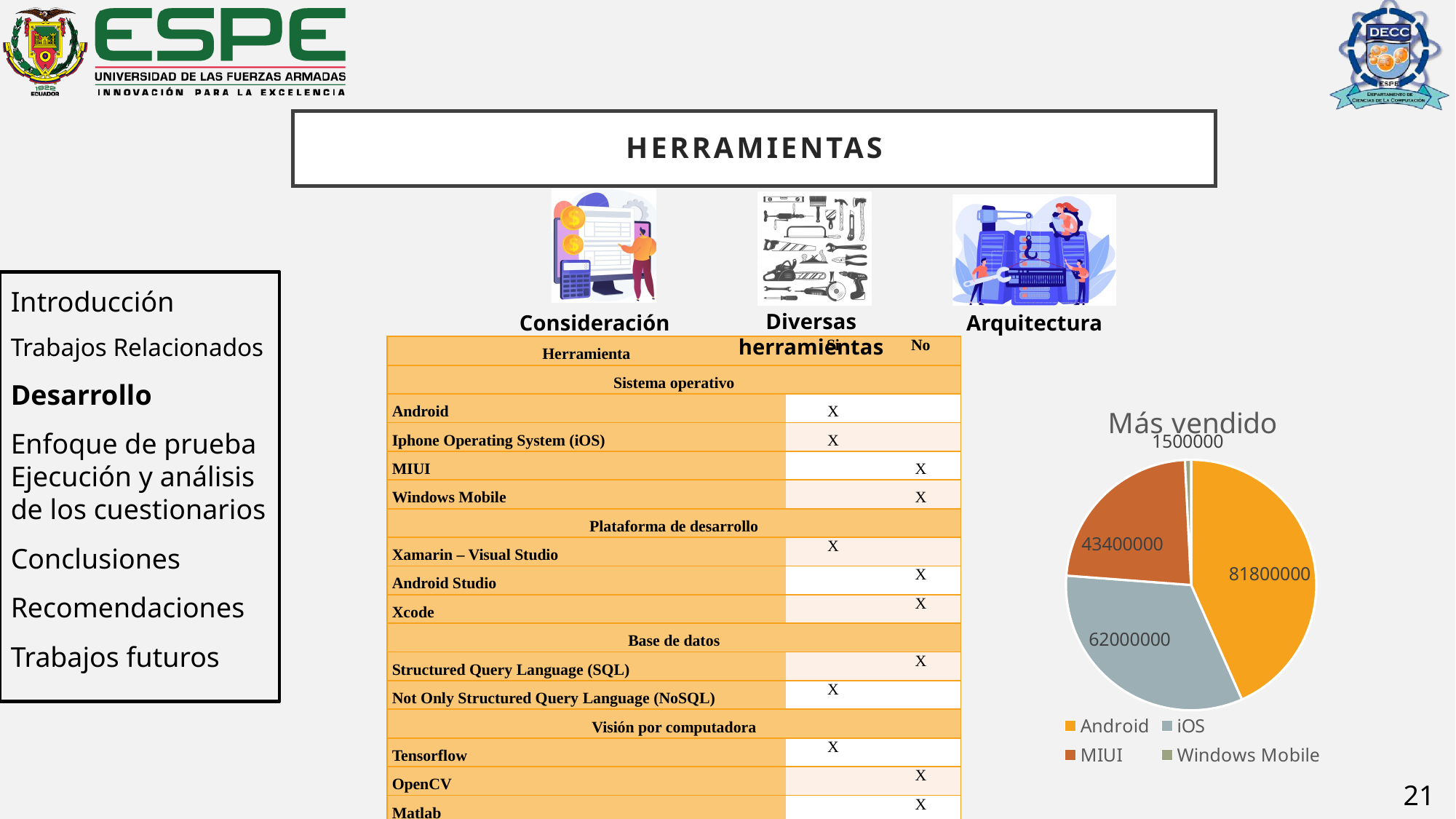
Which category has the smallest slice in the "Más vendido" pie chart? Windows Mobile In the "Más vendido" pie chart, what is the difference between the Android and iOS values? 19800000 What type of chart is shown under the title "Más vendido"? pie chart What is the title of the pie chart on the slide? Más vendido How many categories does the legend of the "Más vendido" pie chart list? 4 In the "Más vendido" pie chart, what is the value for MIUI? 43400000 In the "Más vendido" pie chart, which is larger, the value for iOS or the value for MIUI? iOS In the "Más vendido" pie chart, what is the difference between the iOS and MIUI values? 18600000 In the "Más vendido" pie chart, what is the value for iOS? 62000000 In the "Más vendido" pie chart, what is the value for Windows Mobile? 1500000 In the "Más vendido" pie chart, what is the value for Android? 81800000 Which category has the largest slice in the "Más vendido" pie chart? Android